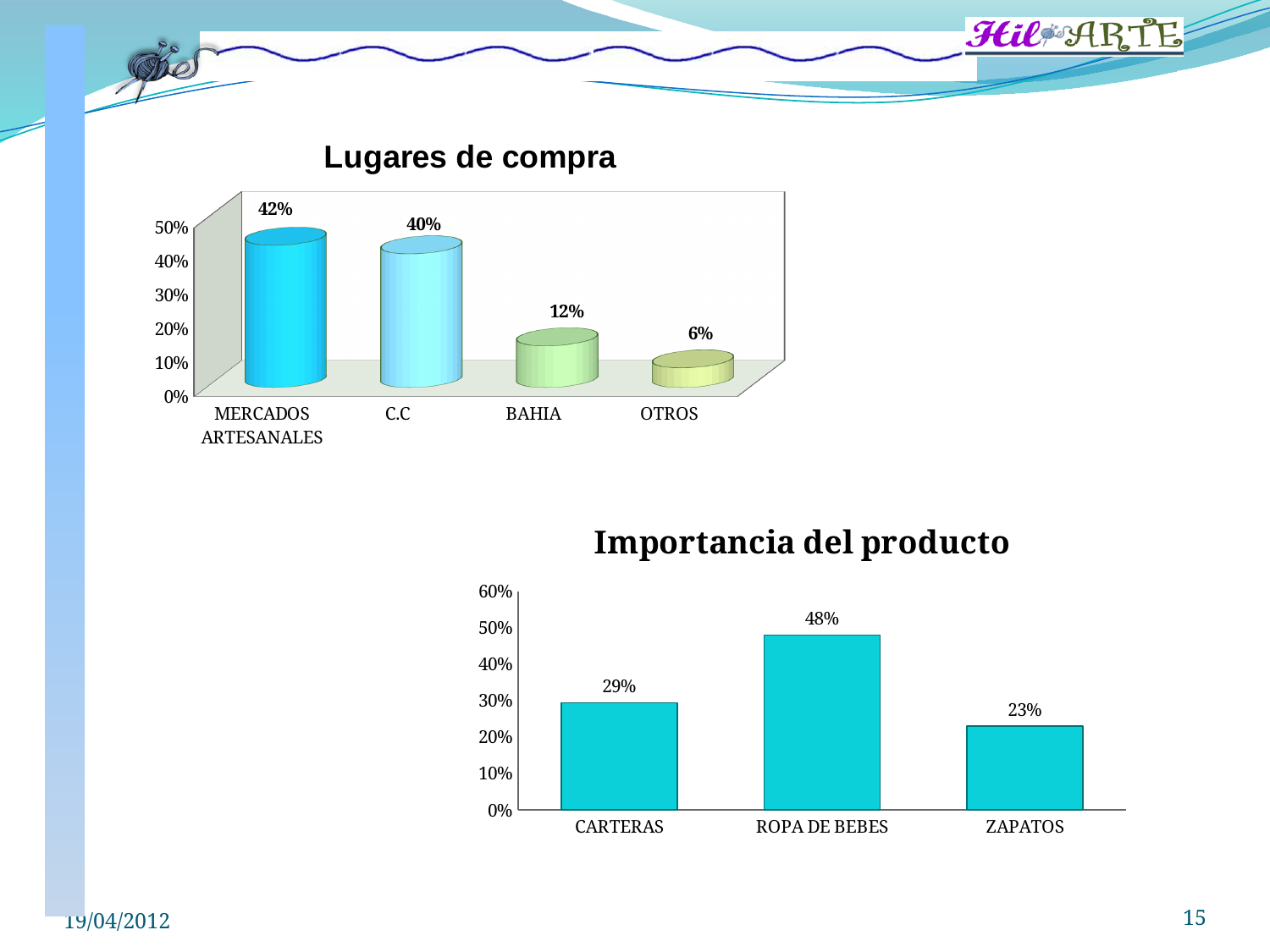
In the 'Importancia del producto' chart, which category has the highest value? ROPA DE BEBES In the 'Importancia del producto' chart, which is larger, CARTERAS or ZAPATOS? CARTERAS In the 'Lugares de compra' chart, what is the value for BAHIA? 12% In the 'Lugares de compra' chart, which category has the lowest value? OTROS What kind of chart is 'Importancia del producto'? Bar chart In the 'Lugares de compra' chart, what is the value for MERCADOS ARTESANALES? 42% In the 'Importancia del producto' chart, what is the difference between ROPA DE BEBES and ZAPATOS? 25% What is the title of the chart at the top of the slide? Lugares de compra In the 'Lugares de compra' chart, how many categories are shown? 4 In the 'Importancia del producto' chart, what is the value for ROPA DE BEBES? 48% In the 'Lugares de compra' chart, what is the difference between C.C and BAHIA? 28% In the 'Lugares de compra' chart, is the value for OTROS greater or less than 10%? less